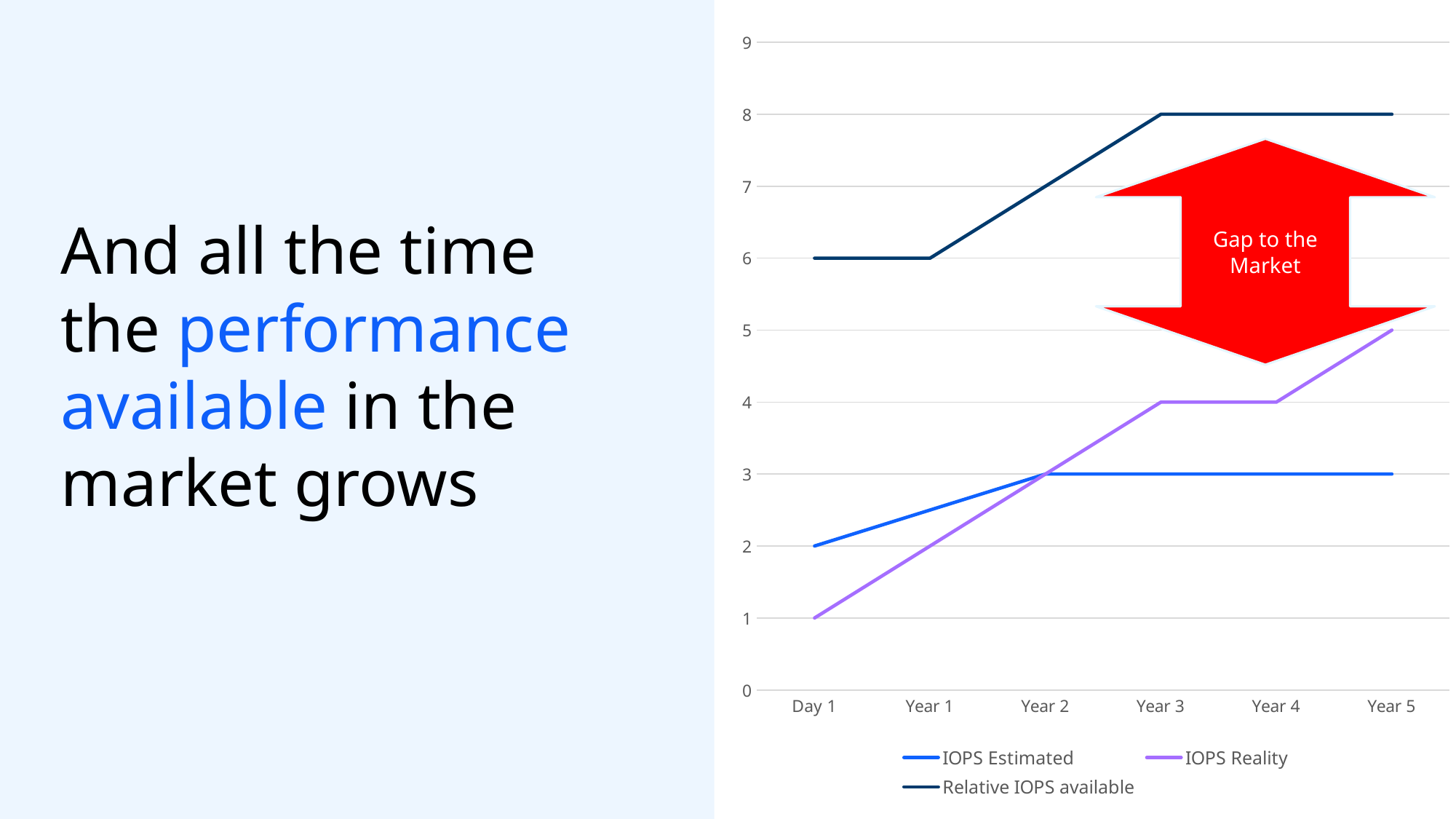
What kind of chart is shown on the slide? line chart How many categories are shown on the x axis? 6 How many series does the legend list? 3 Which is larger at Year 4, IOPS Reality or IOPS Estimated? IOPS Reality What is the difference between Relative IOPS available and IOPS Reality at Year 5? 3 Does IOPS Reality rise or fall from Day 1 to Year 5? rise What text is written inside the red arrow on the chart? Gap to the Market Which series has the highest value at Year 5? Relative IOPS available What is the value of IOPS Estimated at Year 5? 3 What is the value of Relative IOPS available at Year 5? 8 What is the value of IOPS Reality at Day 1? 1 What is the value of Relative IOPS available at Day 1? 6